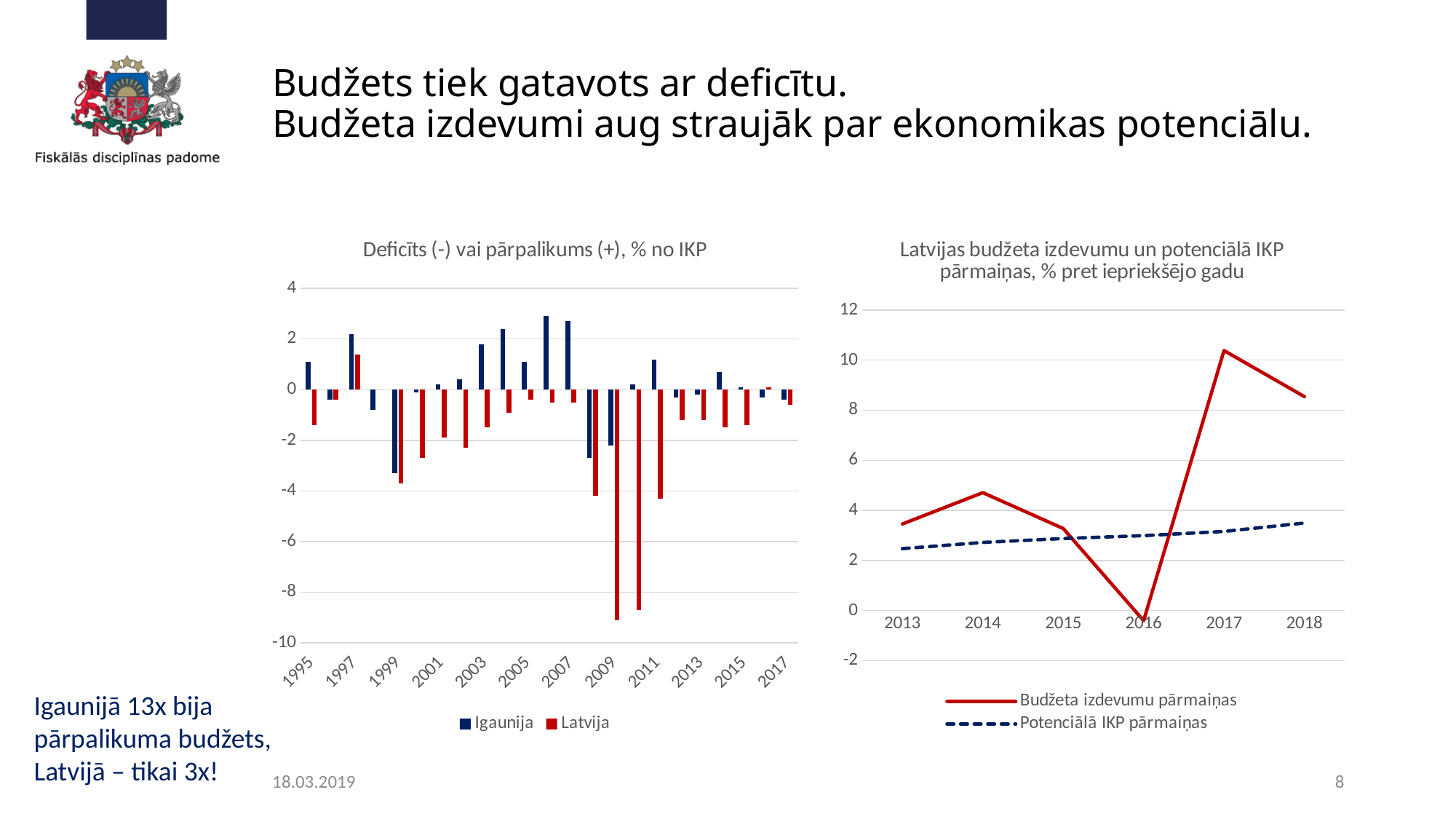
In the right chart, is the value for Budžeta izdevumu pārmaiņas in 2017 greater or less than 10? greater In the right chart, which series has the larger value in 2018, Budžeta izdevumu pārmaiņas or Potenciālā IKP pārmaiņas? Budžeta izdevumu pārmaiņas In the right chart, which year has the highest value for Budžeta izdevumu pārmaiņas? 2017 In the right chart, which year has the lowest value for Budžeta izdevumu pārmaiņas? 2016 In the right chart, does the Potenciālā IKP pārmaiņas line rise or fall from 2013 to 2018? rise How many series does the legend of the left chart list? 2 What kind of chart is the left chart, 'Deficīts (-) vai pārpalikums (+), % no IKP'? bar chart What kind of chart is the right chart, 'Latvijas budžeta izdevumu un potenciālā IKP pārmaiņas'? line chart In the right chart, how many years are plotted on the x axis? 6 In the right chart, is the value for Budžeta izdevumu pārmaiņas in 2016 greater or less than 0? less In the left chart, which series is shown in red? Latvija In the left chart, is the value for Latvija in 2009 greater or less than -8? less